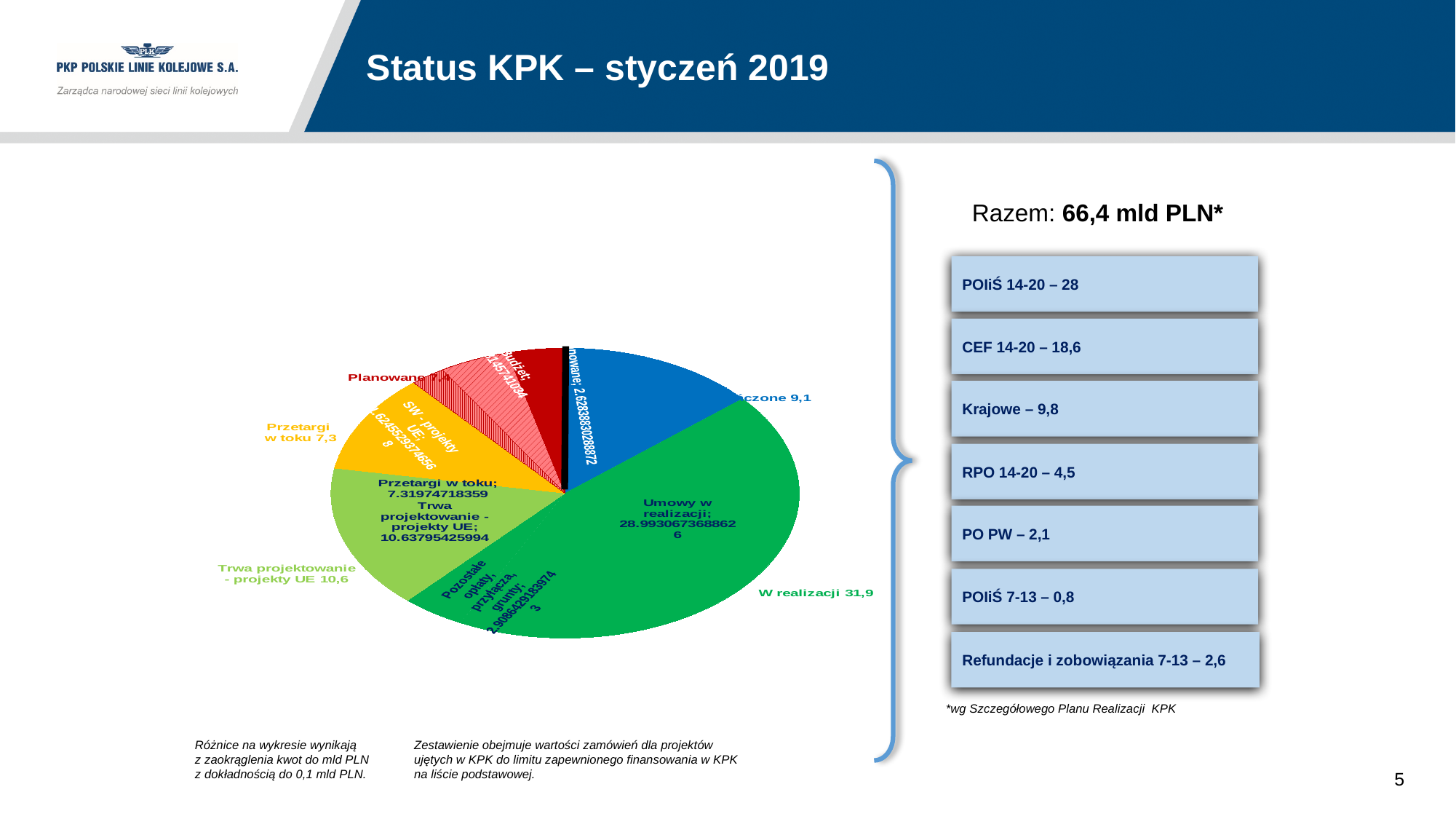
What is the difference between the values for "W realizacji" and "Zakończone" on the pie chart? 22,8 What value is shown for "Przetargi w toku" on the pie chart? 7,3 What kind of chart is shown on the slide? pie chart What colour is the "W realizacji" slice of the pie chart? green Which category has the largest slice of the pie chart? W realizacji What is the difference between the values for "Trwa projektowanie - projekty UE" and "Przetargi w toku" on the pie chart? 3,3 Which is larger on the pie chart: "W realizacji" or "Zakończone"? W realizacji What value is shown for "Zakończone" on the pie chart? 9,1 What value is shown for "Trwa projektowanie - projekty UE" on the pie chart? 10,6 Which is larger on the pie chart: "Trwa projektowanie - projekty UE" or "Przetargi w toku"? Trwa projektowanie - projekty UE What value is shown for "W realizacji" on the pie chart? 31,9